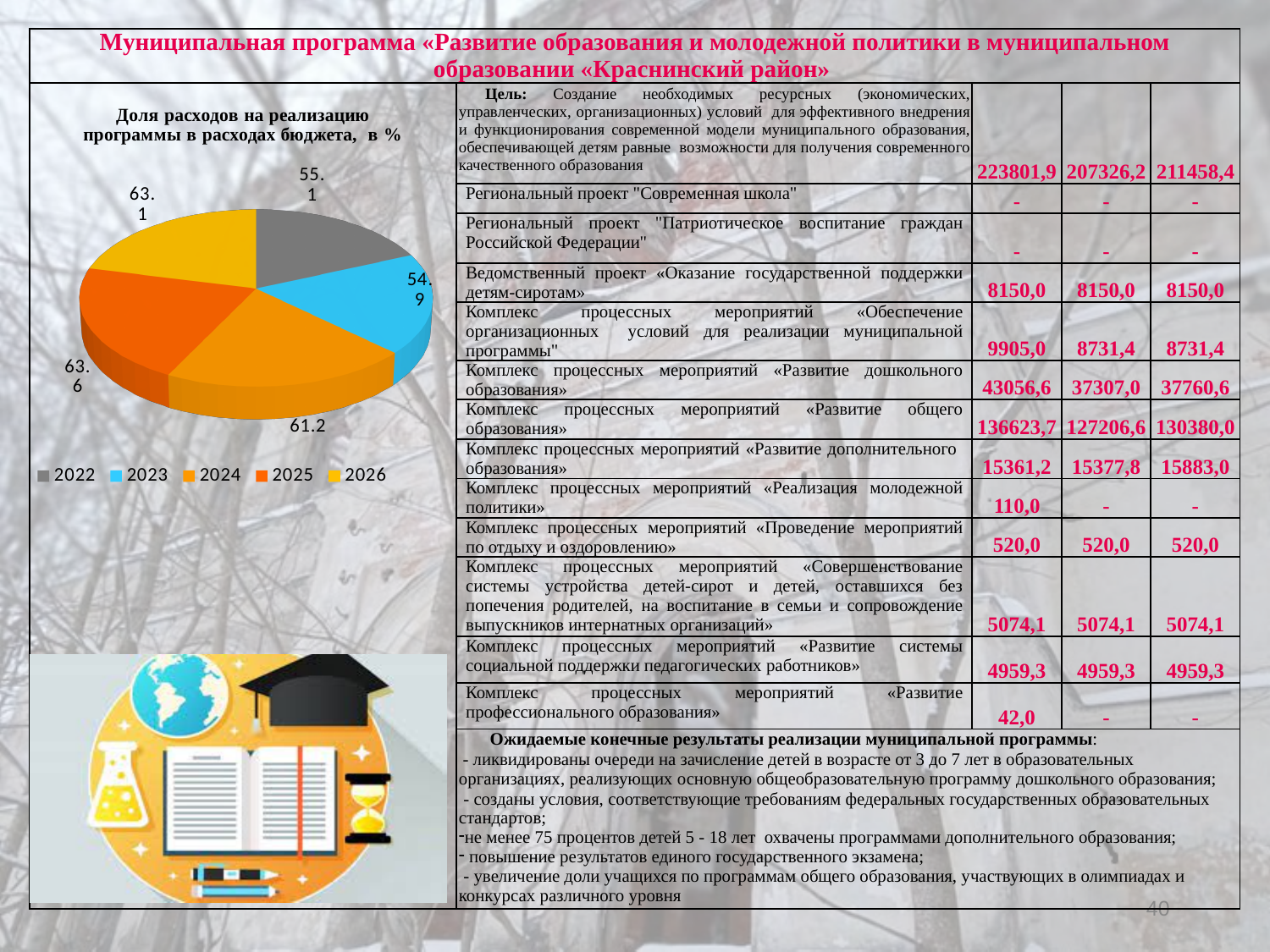
Which year has the lowest value in the pie chart? 2023 What is the title of the pie chart? Доля расходов на реализацию программы в расходах бюджета, в % What is the value shown for 2025 in the pie chart? 63.6 What is the value shown for 2026 in the pie chart? 63.1 What kind of chart is shown on the slide? pie chart How many slices does the pie chart have? 5 What is the value shown for 2023 in the pie chart? 54.9 How many years does the legend of the pie chart list? 5 What is the value shown for 2024 in the pie chart? 61.2 What is the difference between the values for 2024 and 2022 in the pie chart? 6.1 What is the value shown for 2022 in the pie chart? 55.1 Which year has the highest value in the pie chart? 2025